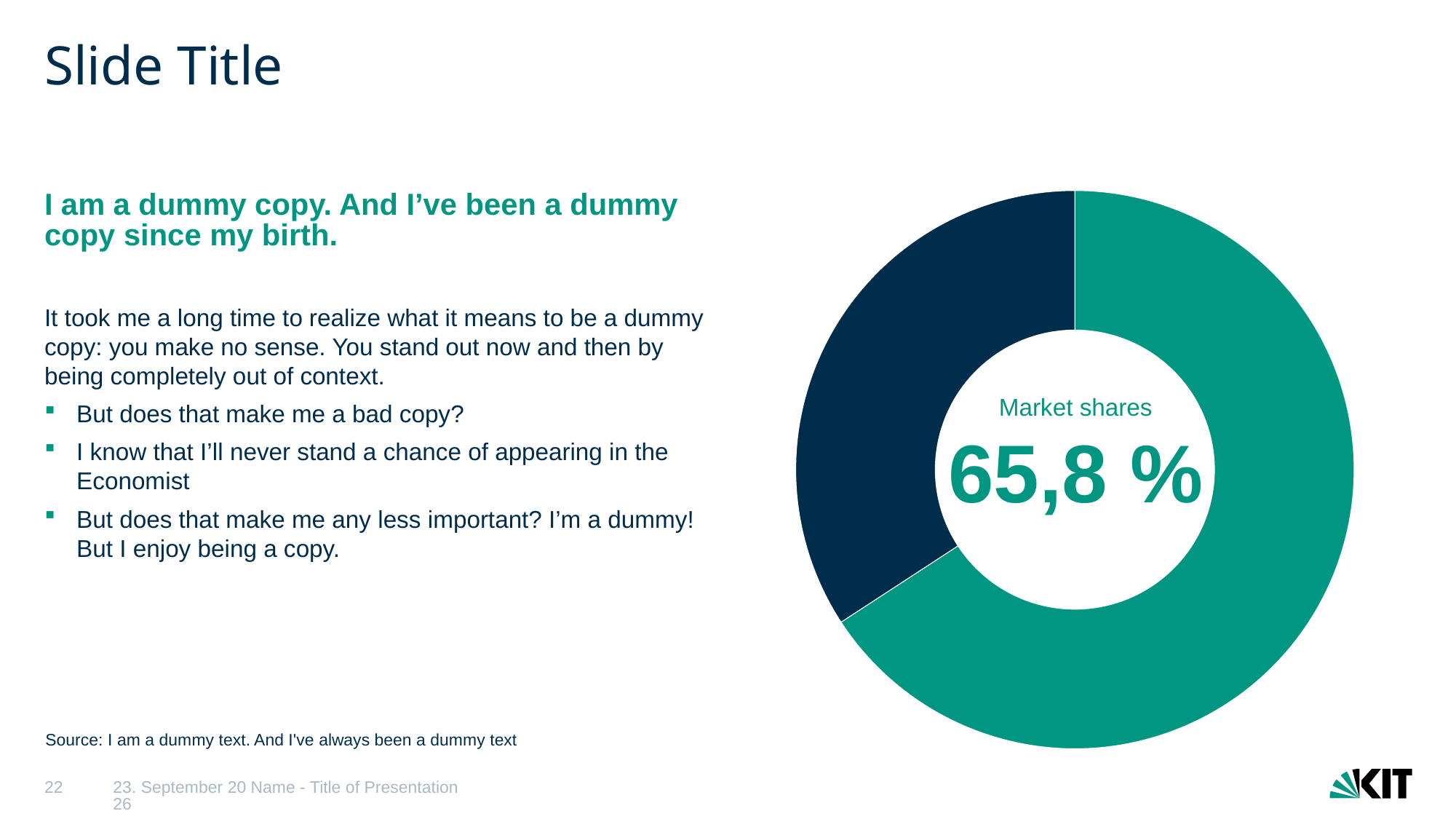
What percentage value is printed in the centre of the donut chart? 65,8 % What text label appears in the centre of the donut chart above the percentage? Market shares Is the share of the dark blue slice greater or less than 50%? less How many slices does the donut chart have? 2 Which slice of the donut chart is the smallest? the dark blue slice What kind of chart is shown on the slide? donut chart What share of the donut chart does the green slice represent? 65,8 % What colour is the largest slice of the donut chart? green Which slice of the donut chart is larger, the green one or the dark blue one? green Is the share of the green slice greater or less than 50%? greater